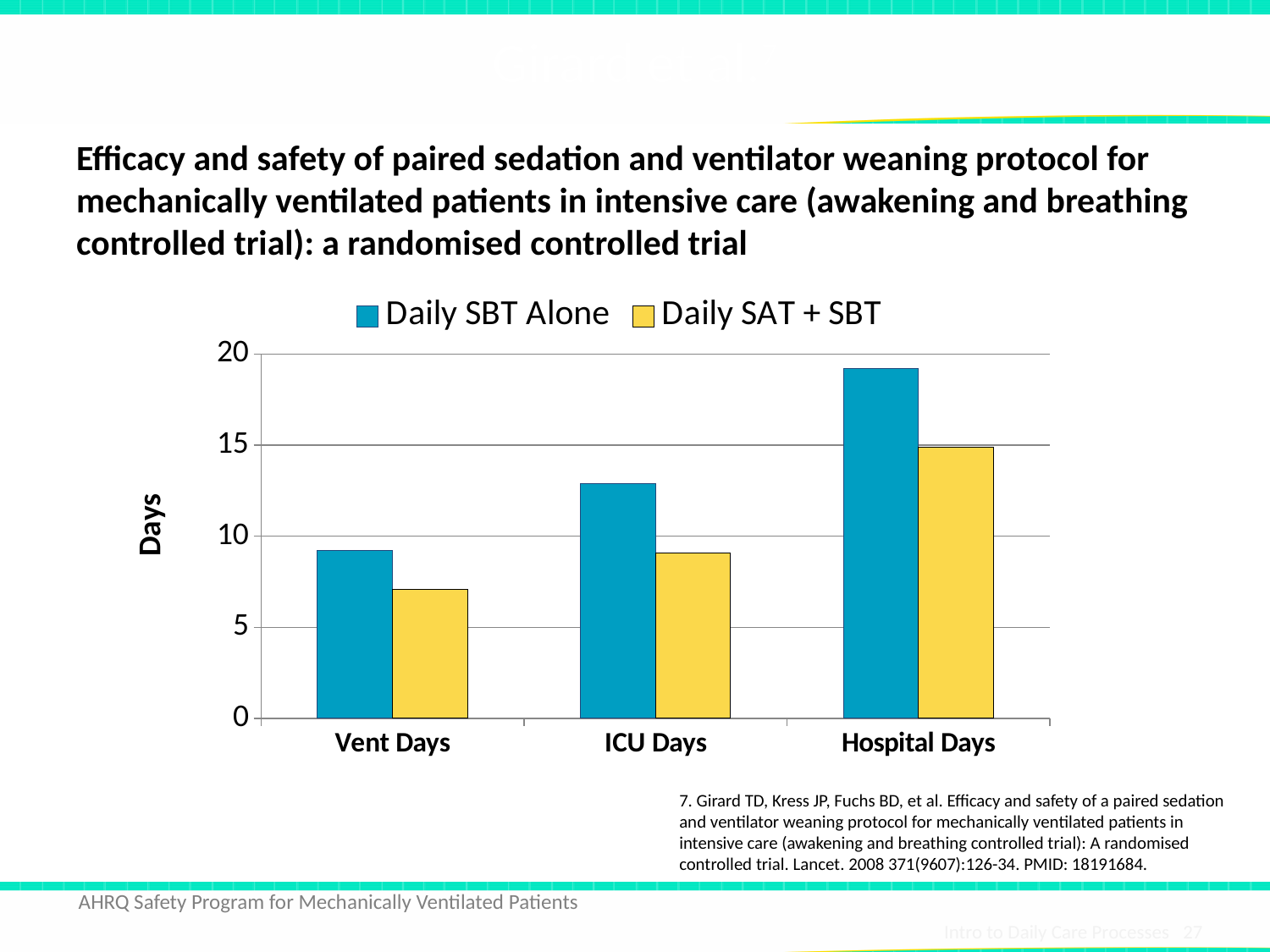
Is the Daily SBT Alone value for ICU Days greater or less than 10? greater Which category has the highest value for Daily SBT Alone? Hospital Days For Hospital Days, which series has the larger value, Daily SBT Alone or Daily SAT + SBT? Daily SBT Alone Which category has the lowest value for Daily SAT + SBT? Vent Days Is the Daily SAT + SBT value for ICU Days greater or less than 10? less What kind of chart is shown on the slide? bar chart Is the Daily SBT Alone value for Hospital Days greater or less than 15? greater For ICU Days, which series has the smaller value, Daily SBT Alone or Daily SAT + SBT? Daily SAT + SBT What is the label on the vertical axis? Days Do the Daily SAT + SBT values rise or fall from Vent Days to Hospital Days? rise How many categories are shown on the x axis? 3 How many series does the legend list? 2